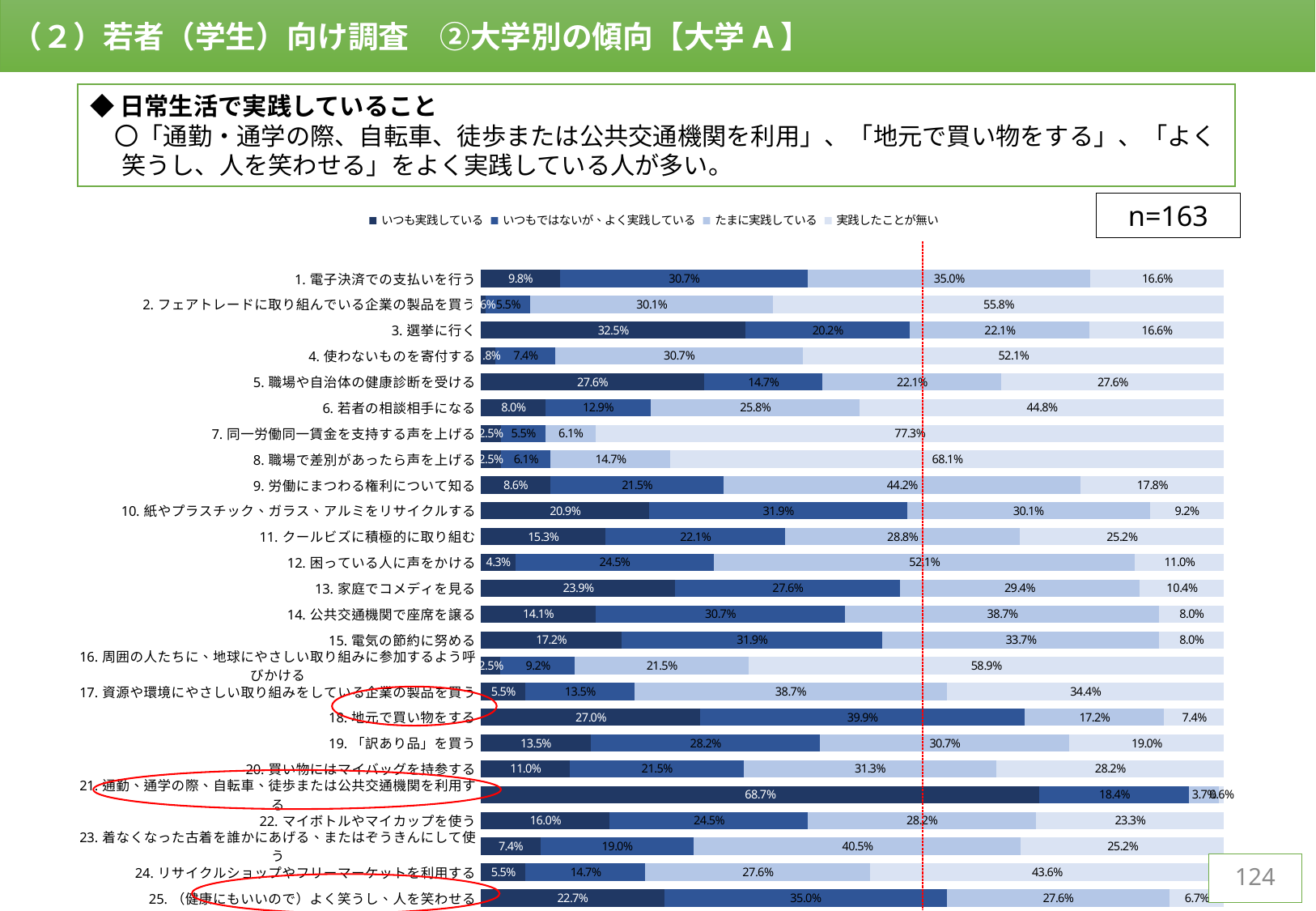
Which has the larger 「いつも実践している」 value: item 3 「選挙に行く」 or item 5 「職場や自治体の健康診断を受ける」? 3. 選挙に行く Which item has the highest value for 「いつも実践している」? 21. 通勤、通学の際、自転車、徒歩または公共交通機関を利用する What is the value of 「いつもではないが、よく実践している」 for item 18 「地元で買い物をする」? 39.9% What sample size (n) is shown on the slide? n=163 For item 18 「地元で買い物をする」, what is the difference between 「いつもではないが、よく実践している」 and 「いつも実践している」? 12.9 percentage points How many series does the legend list? 4 What is the value of 「いつも実践している」 for item 21 「通勤、通学の際、自転車、徒歩または公共交通機関を利用する」? 68.7% Which item has the highest value for 「実践したことが無い」? 7. 同一労働同一賃金を支持する声を上げる What is the value of 「実践したことが無い」 for item 7 「同一労働同一賃金を支持する声を上げる」? 77.3% What kind of chart is shown on the slide? Stacked bar chart How many categories (items) are plotted in the chart? 25 What is the value of 「たまに実践している」 for item 1 「電子決済での支払いを行う」? 35.0%